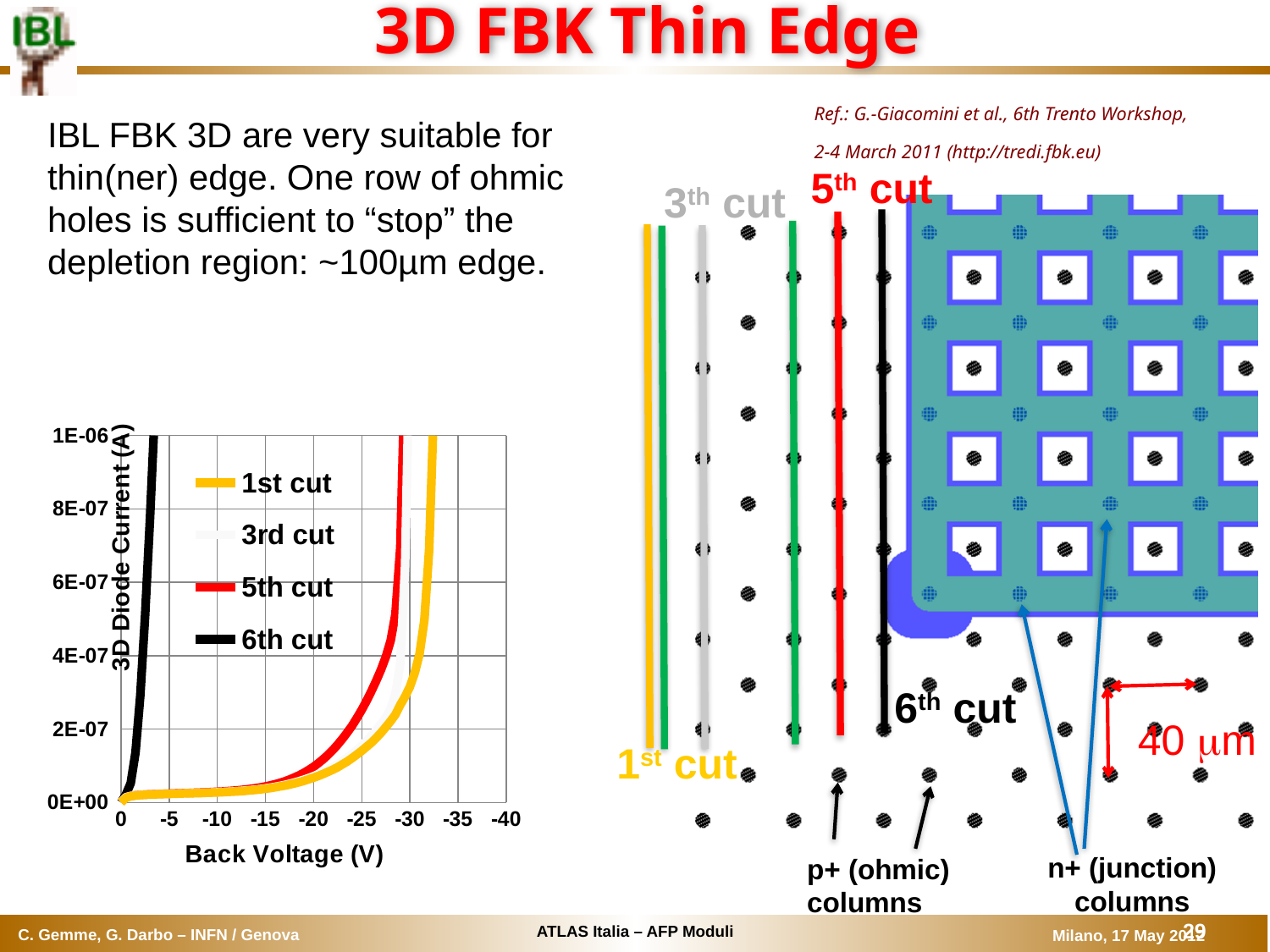
How many tick labels are shown on the x axis of the chart? 9 What are the series names listed in the chart legend? 1st cut, 3rd cut, 5th cut, 6th cut What kind of chart is shown on the slide? line chart How many series does the chart legend list? 4 Which series reaches 1E-06 A at the largest back voltage magnitude? 1st cut At -30 V, which series has the larger diode current, 1st cut or 5th cut? 5th cut Which series reaches 1E-06 A at the smallest back voltage magnitude? 6th cut What is the label of the x axis of the chart? Back Voltage (V) What is the highest tick value shown on the y axis of the chart? 1E-06 Is the 1st cut diode current at -20 V greater or less than 2E-07? less Does the diode current rise or fall as the back voltage goes from 0 toward -40 V? rise